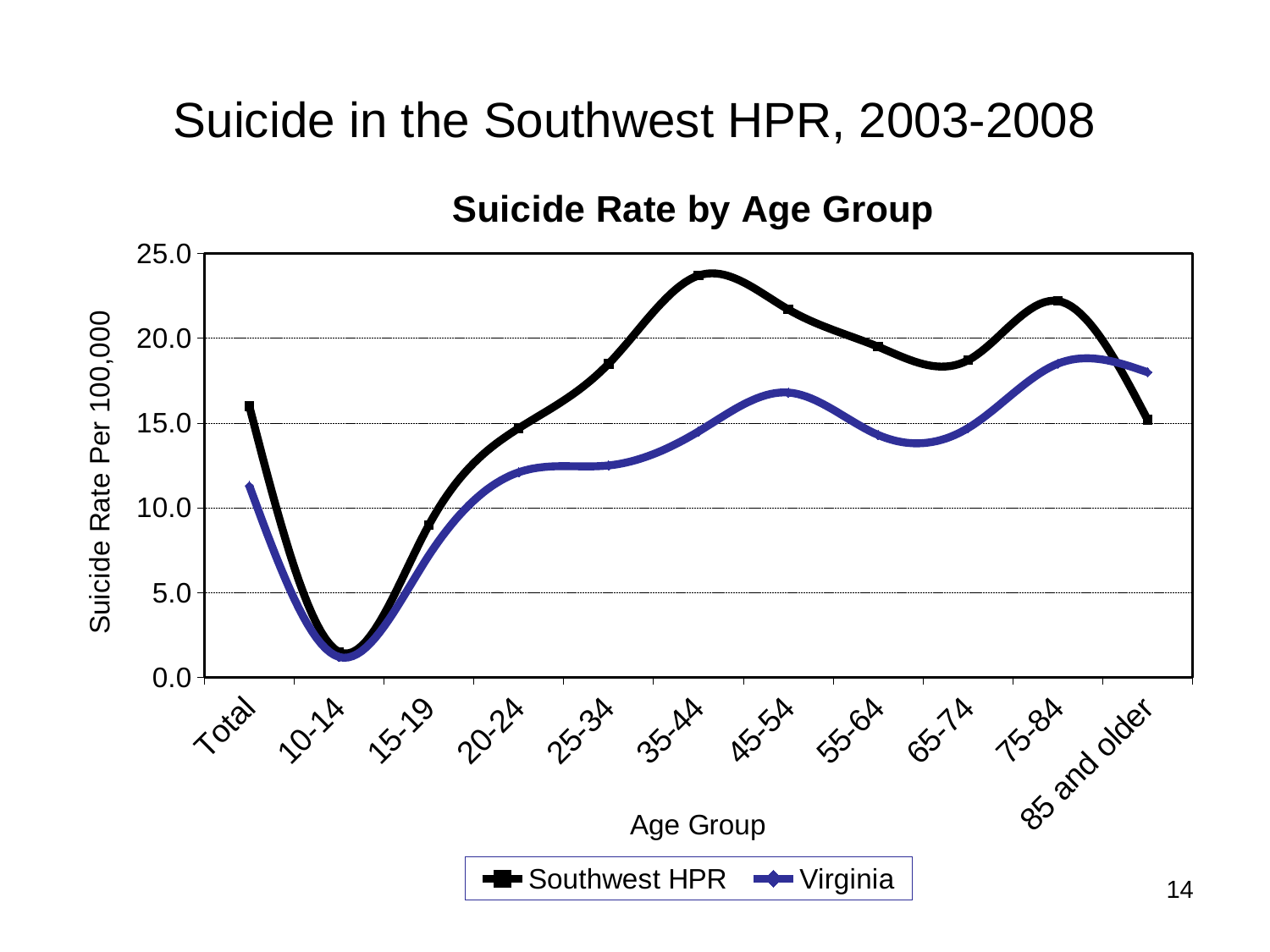
Is the Virginia value for the 10-14 age group greater or less than 5.0? less What kind of chart is shown on the slide? Line chart Is the Southwest HPR value for the 35-44 age group greater or less than 20.0? greater Is the Southwest HPR value for the 15-19 age group greater or less than 10.0? less Which age group has the highest Southwest HPR suicide rate? 35-44 How many age group categories are shown on the x axis? 11 Which age group has the lowest Southwest HPR suicide rate? 10-14 For the 85 and older age group, which series has the higher suicide rate, Southwest HPR or Virginia? Virginia For the 35-44 age group, which series has the higher suicide rate, Southwest HPR or Virginia? Southwest HPR Which age group has the lowest Virginia suicide rate? 10-14 How many series does the legend list? 2